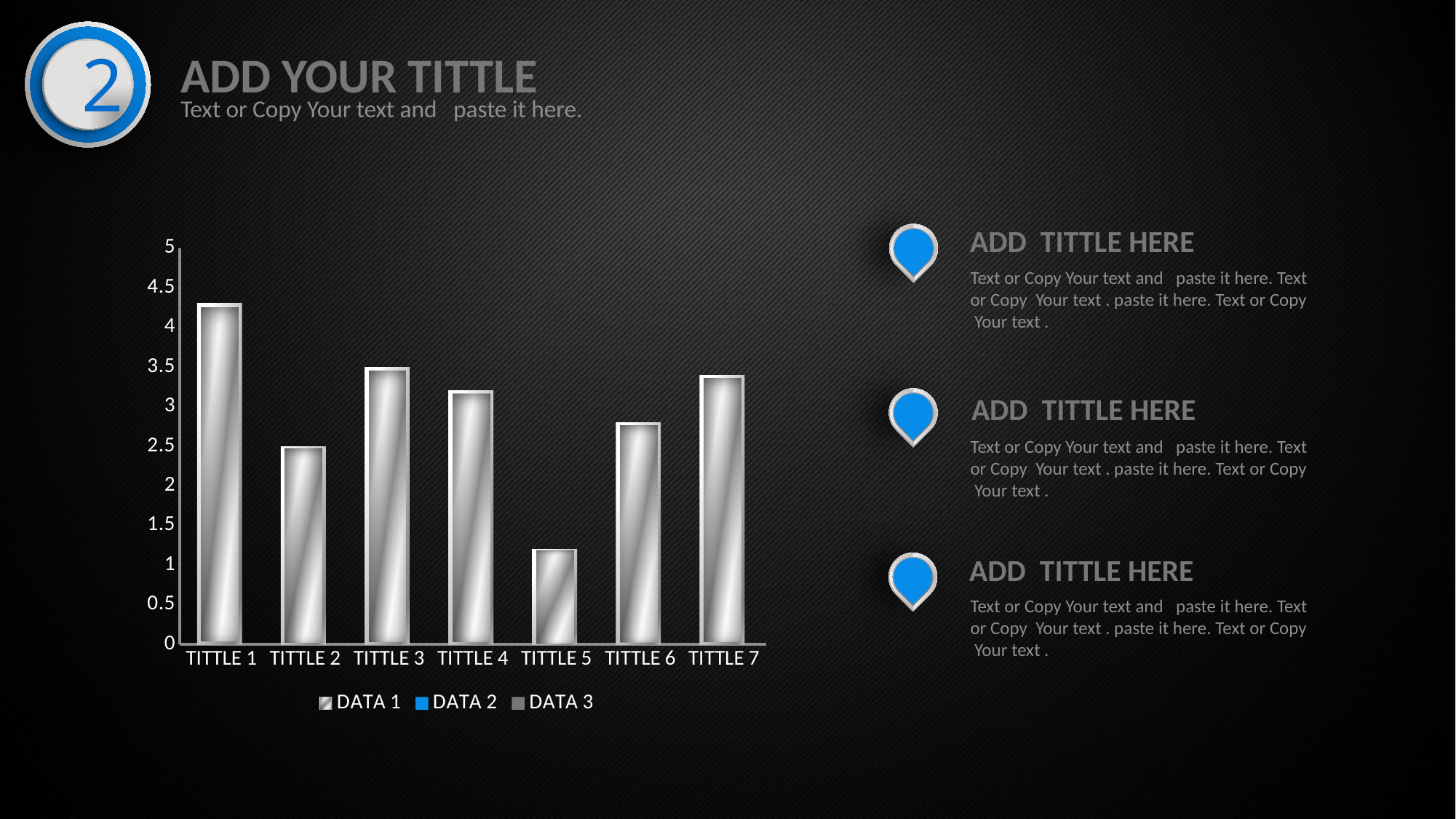
What are the three entries listed in the chart's legend? DATA 1, DATA 2, DATA 3 How many series does the chart's legend list? 3 What kind of chart is shown on the slide? bar chart Is the value for TITTLE 5 greater or less than 1.5? less Is the value for TITTLE 6 greater or less than 2.5? greater Which is larger, the value for TITTLE 1 or the value for TITTLE 2? TITTLE 1 Which category has the highest bar in the chart? TITTLE 1 Which is larger, the value for TITTLE 5 or the value for TITTLE 6? TITTLE 6 Is the value for TITTLE 2 greater or less than 3? less Which category has the lowest bar in the chart? TITTLE 5 How many categories are shown on the x axis of the chart? 7